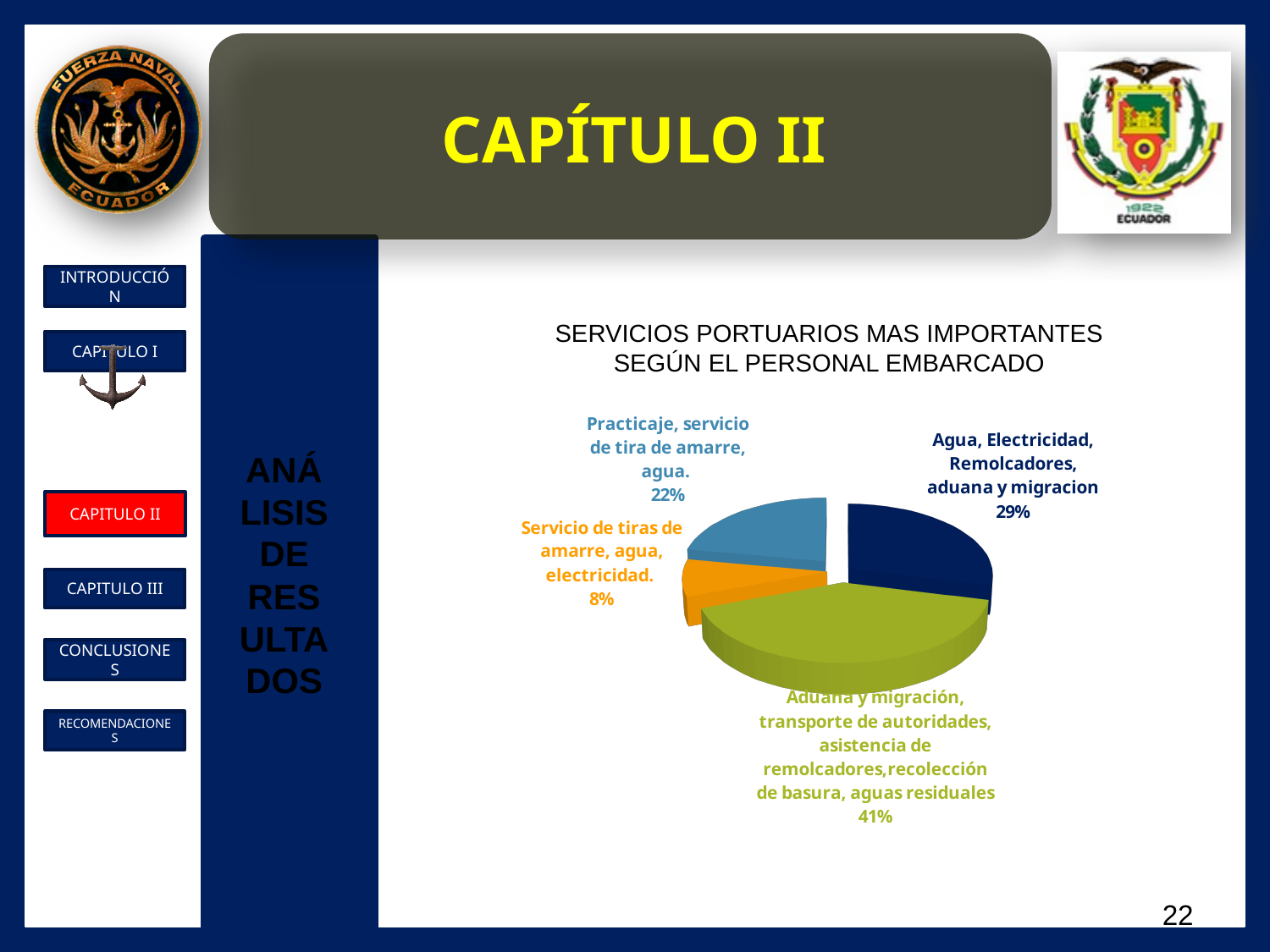
What percentage is shown for "Agua, Electricidad, Remolcadores, aduana y migracion"? 29% What is the title of the chart? SERVICIOS PORTUARIOS MAS IMPORTANTES SEGÚN EL PERSONAL EMBARCADO Which slice of the pie chart is the smallest? Servicio de tiras de amarre, agua, electricidad. How many slices does the pie chart have? 4 What percentage is shown for "Practicaje, servicio de tira de amarre, agua."? 22% What percentage is shown for "Servicio de tiras de amarre, agua, electricidad."? 8% What percentage is shown for "Aduana y migración, transporte de autoridades, asistencia de remolcadores, recolección de basura, aguas residuales"? 41% What colour is the slice representing 41%? Green Which slice of the pie chart is the largest? Aduana y migración, transporte de autoridades, asistencia de remolcadores, recolección de basura, aguas residuales Which is larger: the share for "Practicaje, servicio de tira de amarre, agua." or the share for "Servicio de tiras de amarre, agua, electricidad."? Practicaje, servicio de tira de amarre, agua. What is the difference in percentage points between the largest slice (41%) and the "Agua, Electricidad, Remolcadores, aduana y migracion" slice (29%)? 12 What kind of chart is shown on the slide? Pie chart